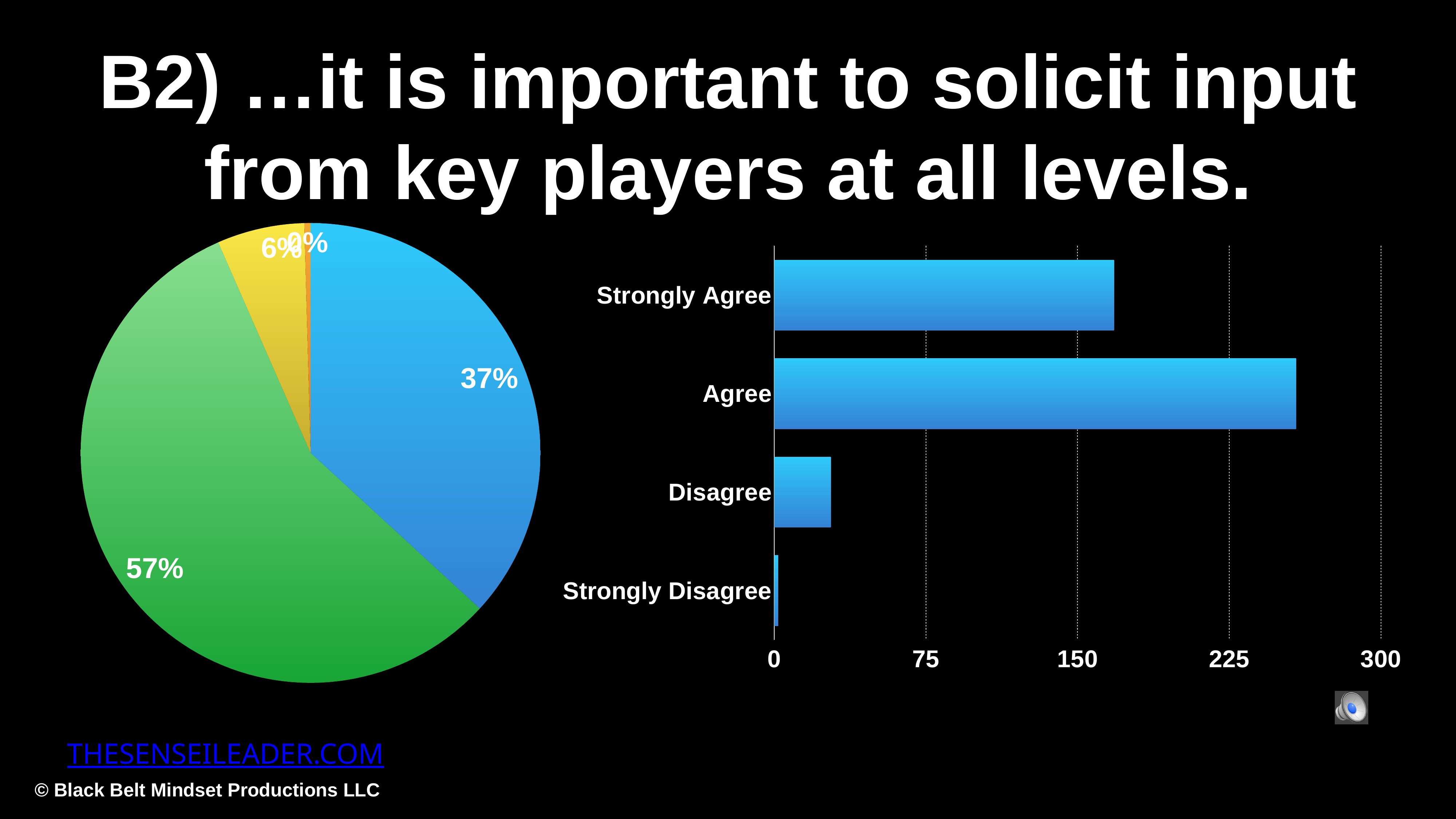
How many categories are shown in the bar chart on the right? 4 In the bar chart on the right, is the value for Strongly Agree greater or less than 150? greater What is the highest value shown on the horizontal axis of the bar chart on the right? 300 In the pie chart on the left, what share does the green slice represent? 57% In the bar chart on the right, which category has the lowest value? Strongly Disagree What kind of chart is the chart on the right side of the slide? bar chart In the bar chart on the right, which is larger: Strongly Agree or Disagree? Strongly Agree In the pie chart on the left, what share does the blue slice represent? 37% In the bar chart on the right, is the value for Agree greater or less than 225? greater What kind of chart is the chart on the left side of the slide? pie chart In the bar chart on the right, which category has the highest value? Agree In the bar chart on the right, is the value for Disagree greater or less than 75? less